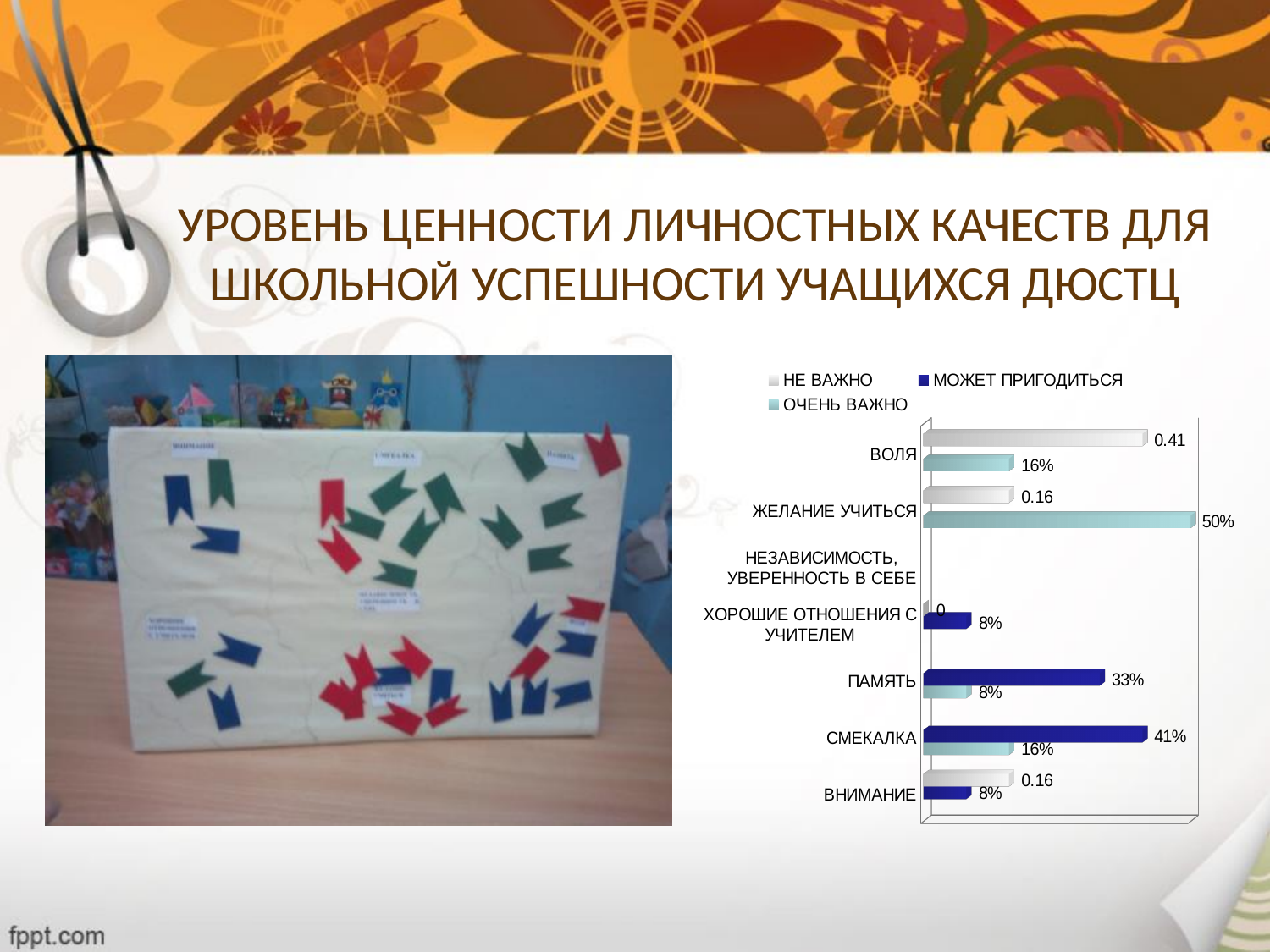
What is the МОЖЕТ ПРИГОДИТЬСЯ value for СМЕКАЛКА? 41% What kind of chart is shown on the slide? bar chart How many categories are shown on the chart's vertical axis? 7 Which category has the highest ОЧЕНЬ ВАЖНО value? ЖЕЛАНИЕ УЧИТЬСЯ What is the НЕ ВАЖНО value for ВОЛЯ? 0.41 What is the difference between the МОЖЕТ ПРИГОДИТЬСЯ values for СМЕКАЛКА and ПАМЯТЬ? 8% Which is larger: the ОЧЕНЬ ВАЖНО value for СМЕКАЛКА or for ПАМЯТЬ? СМЕКАЛКА Which category has the highest МОЖЕТ ПРИГОДИТЬСЯ value? СМЕКАЛКА How many series does the chart legend list? 3 What is the ОЧЕНЬ ВАЖНО value for ЖЕЛАНИЕ УЧИТЬСЯ? 50% What is the ОЧЕНЬ ВАЖНО value for ВОЛЯ? 16% What is the МОЖЕТ ПРИГОДИТЬСЯ value for ПАМЯТЬ? 33%